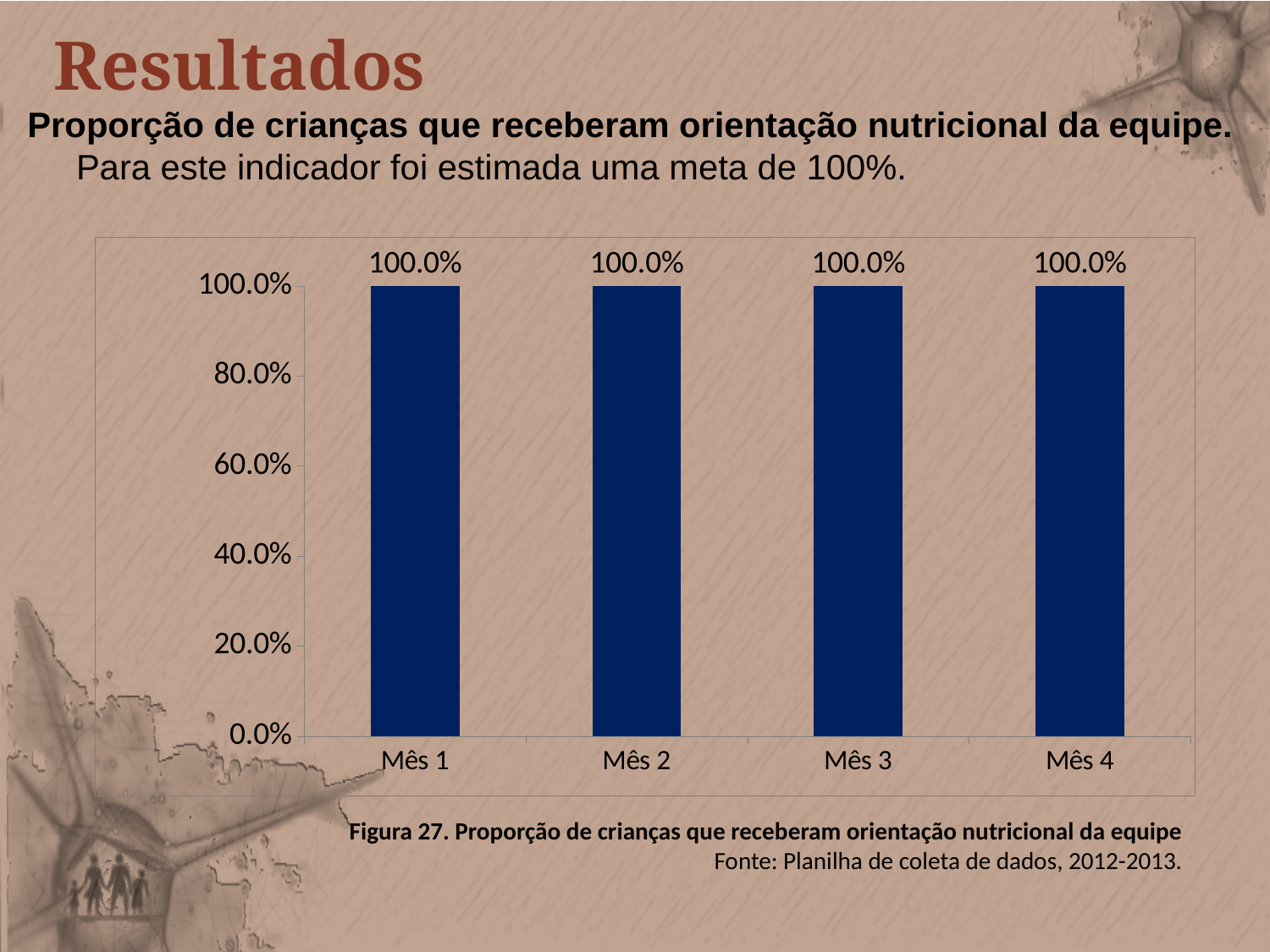
What colour are the bars in the chart? dark blue What is the value for Mês 3? 100.0% What is the difference between the values for Mês 2 and Mês 4? 0.0% What is the value for Mês 4? 100.0% What kind of chart is shown on the slide? bar chart Is the value for Mês 1 larger than, smaller than, or equal to the value for Mês 3? equal Is the value for Mês 2 greater or less than 80.0%? greater What is the figure caption below the chart? Figura 27. Proporção de crianças que receberam orientação nutricional da equipe What is the value for Mês 1? 100.0% How many categories are shown on the x axis? 4 Do the values rise, fall or stay the same from Mês 1 to Mês 4? stay the same